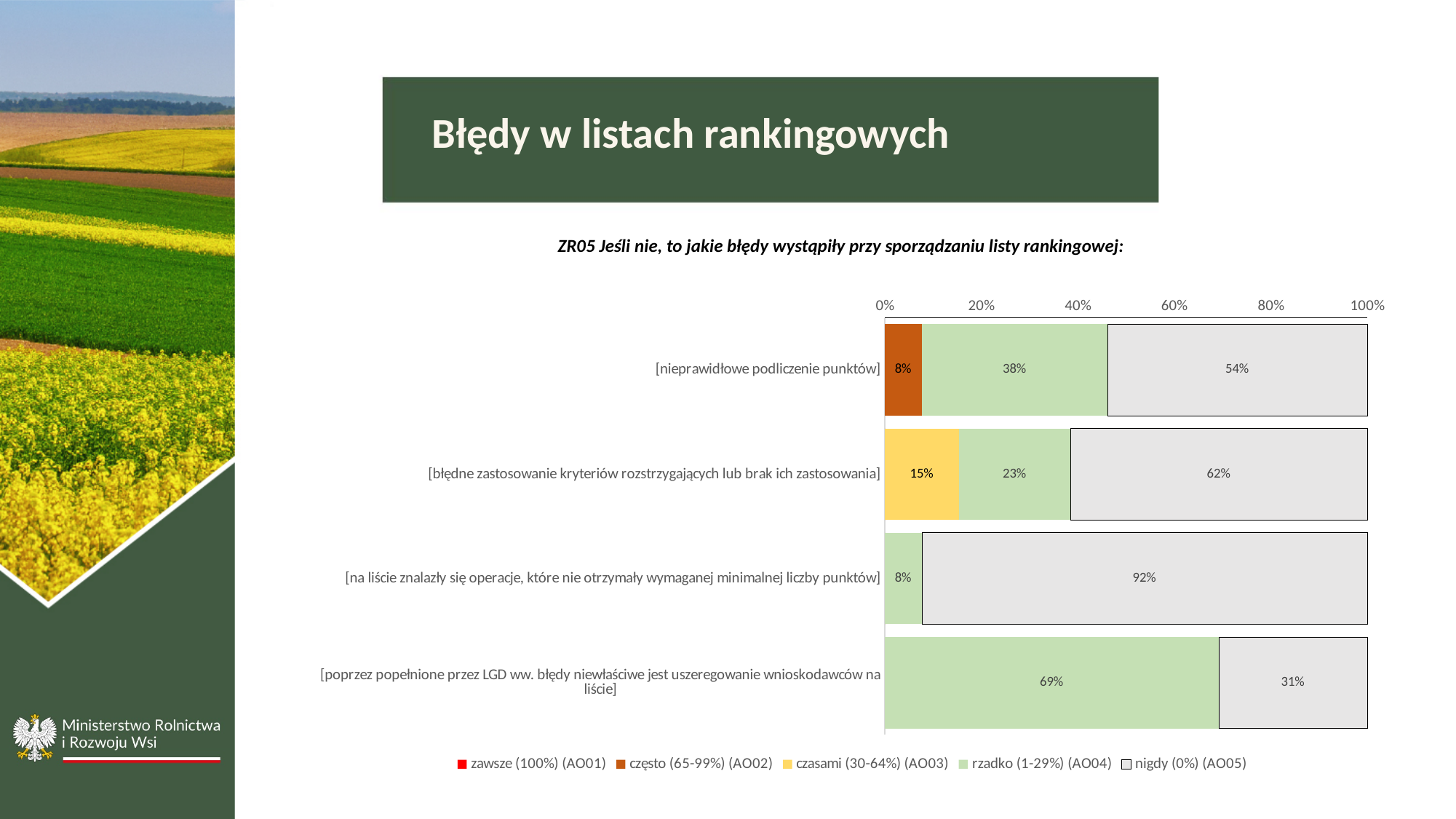
What is the question text shown above the chart? ZR05 Jeśli nie, to jakie błędy wystąpiły przy sporządzaniu listy rankingowej: Which is larger: the 'rzadko (1-29%) (AO04)' value for '[nieprawidłowe podliczenie punktów]' or for '[błędne zastosowanie kryteriów rozstrzygających lub brak ich zastosowania]'? [nieprawidłowe podliczenie punktów] How many categories (error types) are plotted in the chart? 4 What is the total of the stacked bar for '[na liście znalazły się operacje, które nie otrzymały wymaganej minimalnej liczby punktów]'? 100% Which category has the lowest value for 'nigdy (0%) (AO05)'? [poprzez popełnione przez LGD ww. błędy niewłaściwe jest uszeregowanie wnioskodawców na liście] What is the value of 'nigdy (0%) (AO05)' for '[nieprawidłowe podliczenie punktów]'? 54% What is the value of 'czasami (30-64%) (AO03)' for '[błędne zastosowanie kryteriów rozstrzygających lub brak ich zastosowania]'? 15% What is the value of 'rzadko (1-29%) (AO04)' for '[poprzez popełnione przez LGD ww. błędy niewłaściwe jest uszeregowanie wnioskodawców na liście]'? 69% What is the difference between the 'nigdy (0%) (AO05)' values for '[błędne zastosowanie kryteriów rozstrzygających lub brak ich zastosowania]' and '[nieprawidłowe podliczenie punktów]'? 8% Which category has the highest value for 'nigdy (0%) (AO05)'? [na liście znalazły się operacje, które nie otrzymały wymaganej minimalnej liczby punktów] How many series does the legend list? 5 What type of chart is shown on the slide? Stacked bar chart